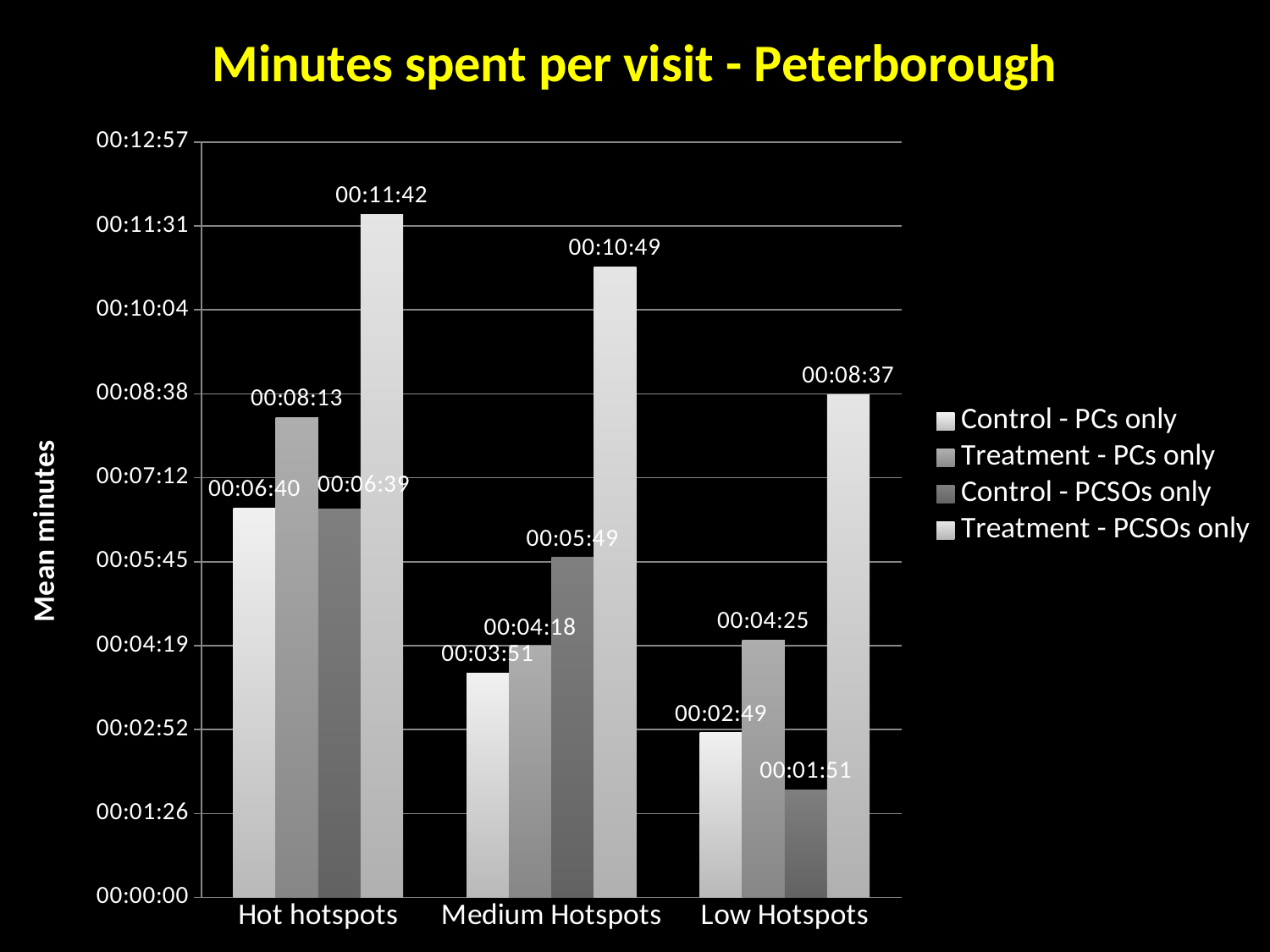
Which series has the lowest value in Low Hotspots? Control - PCSOs only What type of chart is shown on the slide? bar chart What is the value for Control - PCs only in Medium Hotspots? 00:03:51 How many hotspot categories are shown on the x axis? 3 How many series does the legend list? 4 Which series has the highest value in Medium Hotspots? Treatment - PCSOs only What is the title of the chart? Minutes spent per visit - Peterborough What is the value for Treatment - PCSOs only in Hot hotspots? 00:11:42 What is the value for Control - PCSOs only in Low Hotspots? 00:01:51 Which is larger in Hot hotspots: Treatment - PCs only or Control - PCs only? Treatment - PCs only How does the Treatment - PCSOs only value change from Hot hotspots to Low Hotspots? It falls What is the difference between Treatment - PCSOs only in Hot hotspots and in Medium Hotspots? 00:00:53